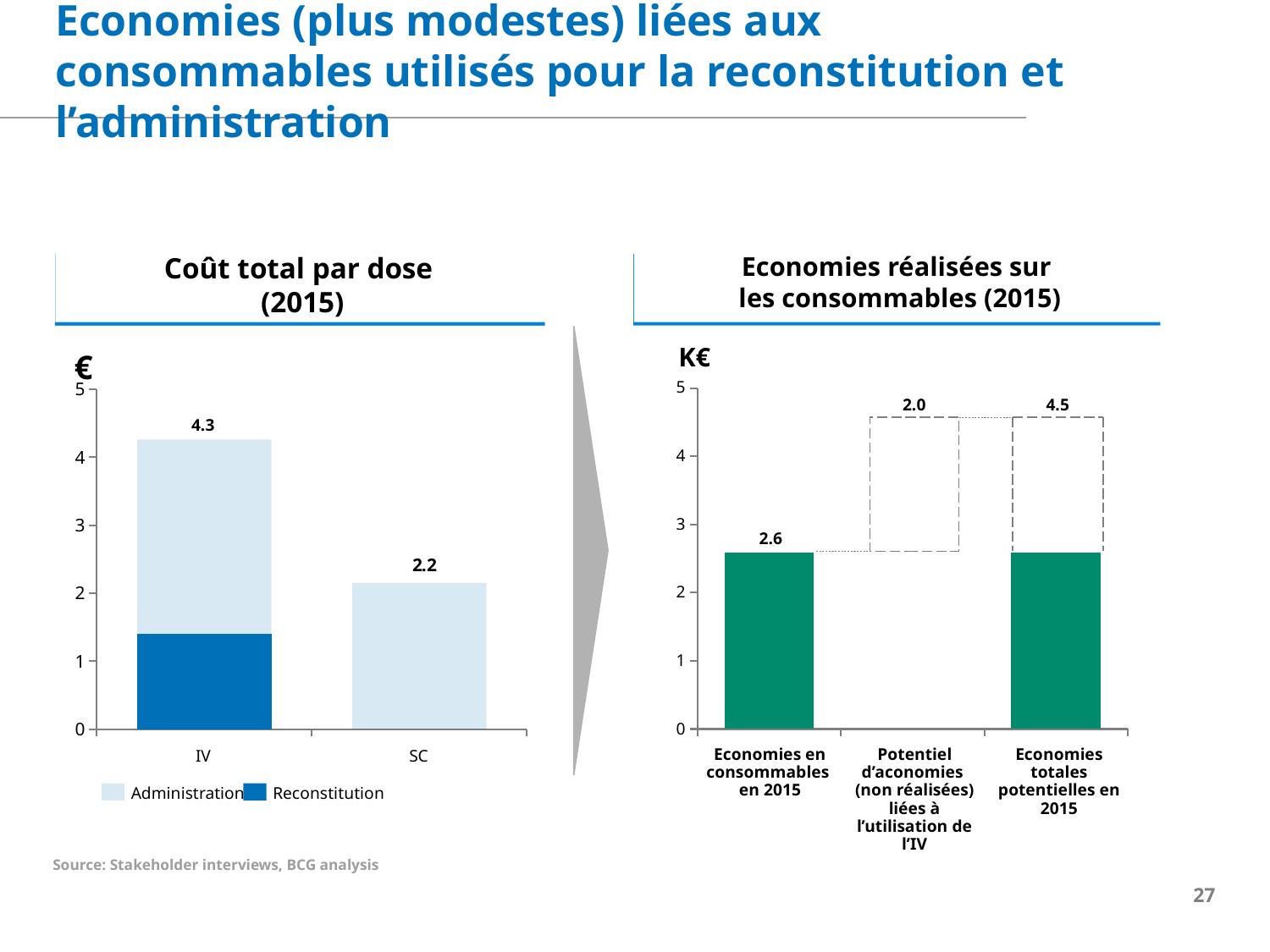
In the chart 'Coût total par dose (2015)', what is the total cost per dose for IV? 4.3 In the chart 'Economies réalisées sur les consommables (2015)', what is the value for 'Potentiel d'aconomies (non réalisées) liées à l'utilisation de l'IV'? 2.0 In the chart 'Coût total par dose (2015)', which category has the higher total cost per dose? IV In the chart 'Coût total par dose (2015)', what unit is shown on the y axis? € In the chart 'Economies réalisées sur les consommables (2015)', what is the value for 'Economies en consommables en 2015'? 2.6 In the chart 'Coût total par dose (2015)', what is the total cost per dose for SC? 2.2 In the chart 'Coût total par dose (2015)', what is the difference between the IV and SC totals? 2.1 In the chart 'Economies réalisées sur les consommables (2015)', which category has the lowest value? Potentiel d'aconomies (non réalisées) liées à l'utilisation de l'IV What kind of chart is 'Economies réalisées sur les consommables (2015)'? Bar chart In the chart 'Economies réalisées sur les consommables (2015)', what is the value for 'Economies totales potentielles en 2015'? 4.5 In the chart 'Coût total par dose (2015)', how many series does the legend list? 2 In the chart 'Coût total par dose (2015)', is the Reconstitution value for IV greater or less than 1? greater